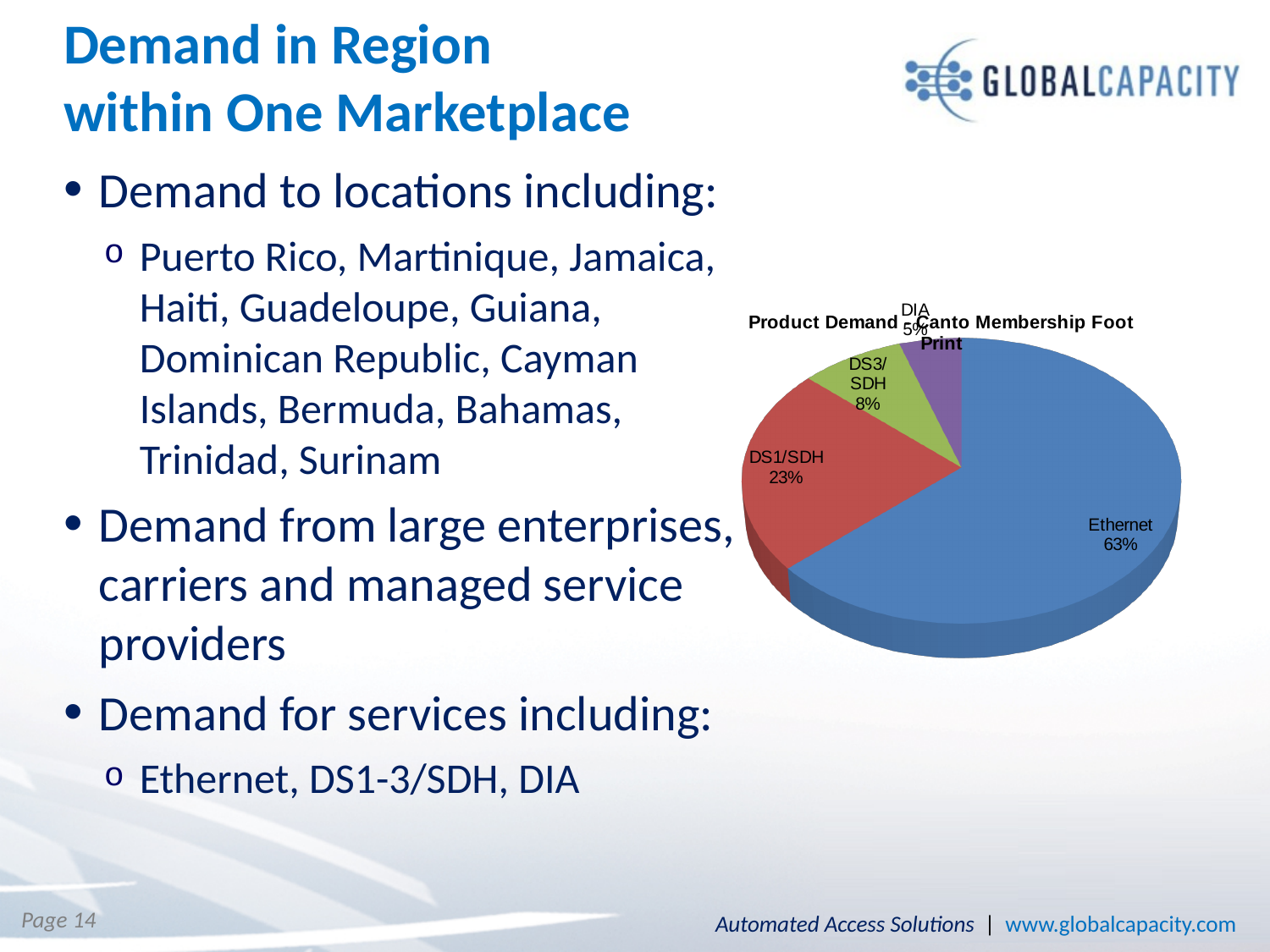
What is the difference in percentage points between the DS1/SDH and DS3/SDH slices? 15 Which slice of the pie is the smallest? DIA Which is larger, the DS3/SDH slice or the DIA slice? DS3/SDH What share of the pie does DS1/SDH have? 23% What share of the pie does DS3/SDH have? 8% What share of the pie does DIA have? 5% How many slices does the pie chart have? 4 What kind of chart is shown on the slide? pie chart What is the difference in percentage points between the Ethernet and DS1/SDH slices? 40 What colour is the Ethernet slice of the pie? blue Which slice of the pie is the largest? Ethernet What share of the pie does Ethernet have? 63%